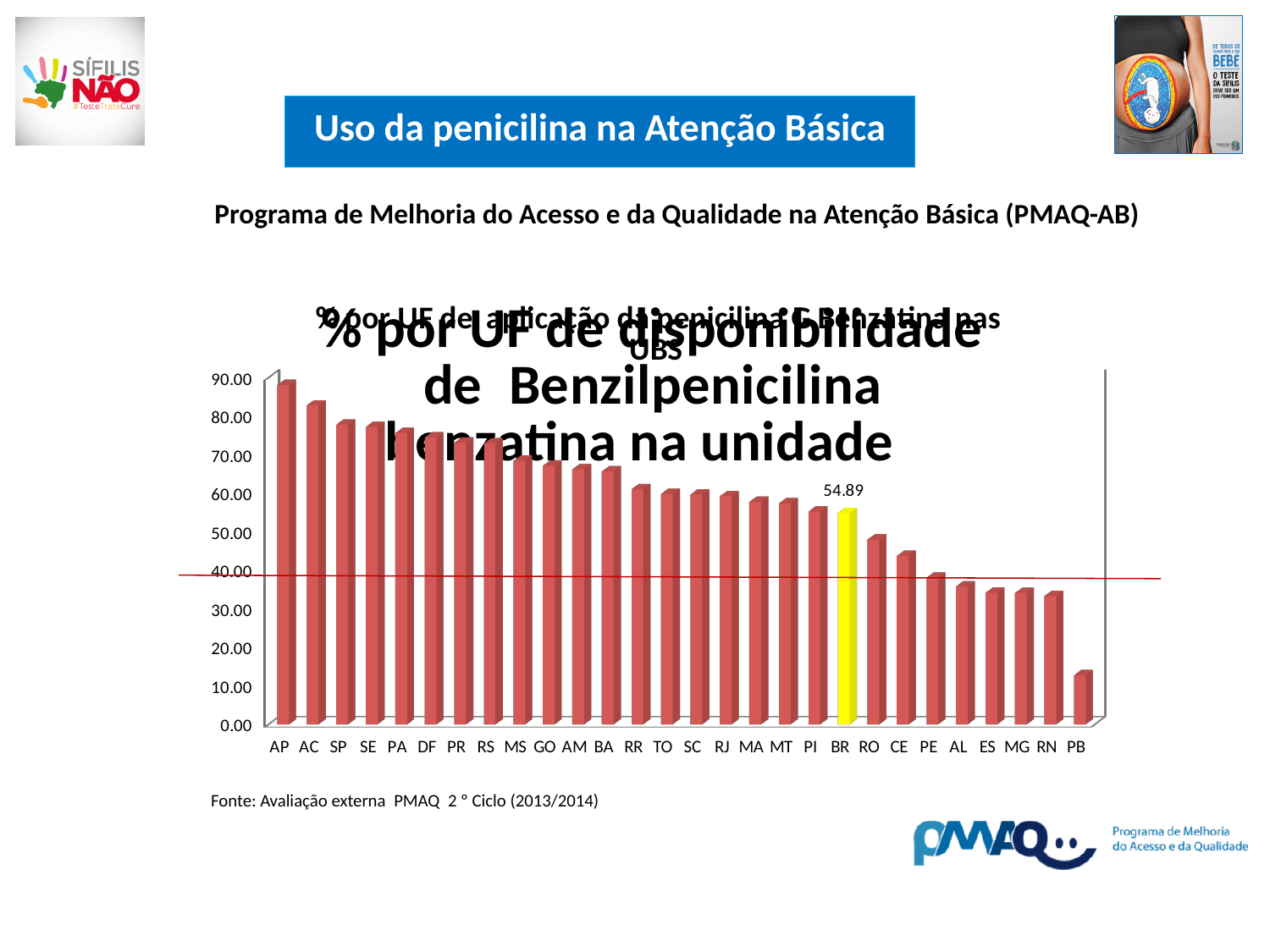
Is the value for AP greater or less than 80.00? greater What kind of chart is shown on the slide? bar chart Which has the larger value, SP or RO? SP Which category's bar is highlighted in yellow? BR What is the value shown for BR? 54.89 Which category has the highest bar? AP Do the values rise or fall moving from left to right along the x axis? fall Is the value for CE greater or less than 50.00? less Which category has the lowest bar? PB Is the value for SP greater or less than 70.00? greater How many categories are plotted along the x axis? 28